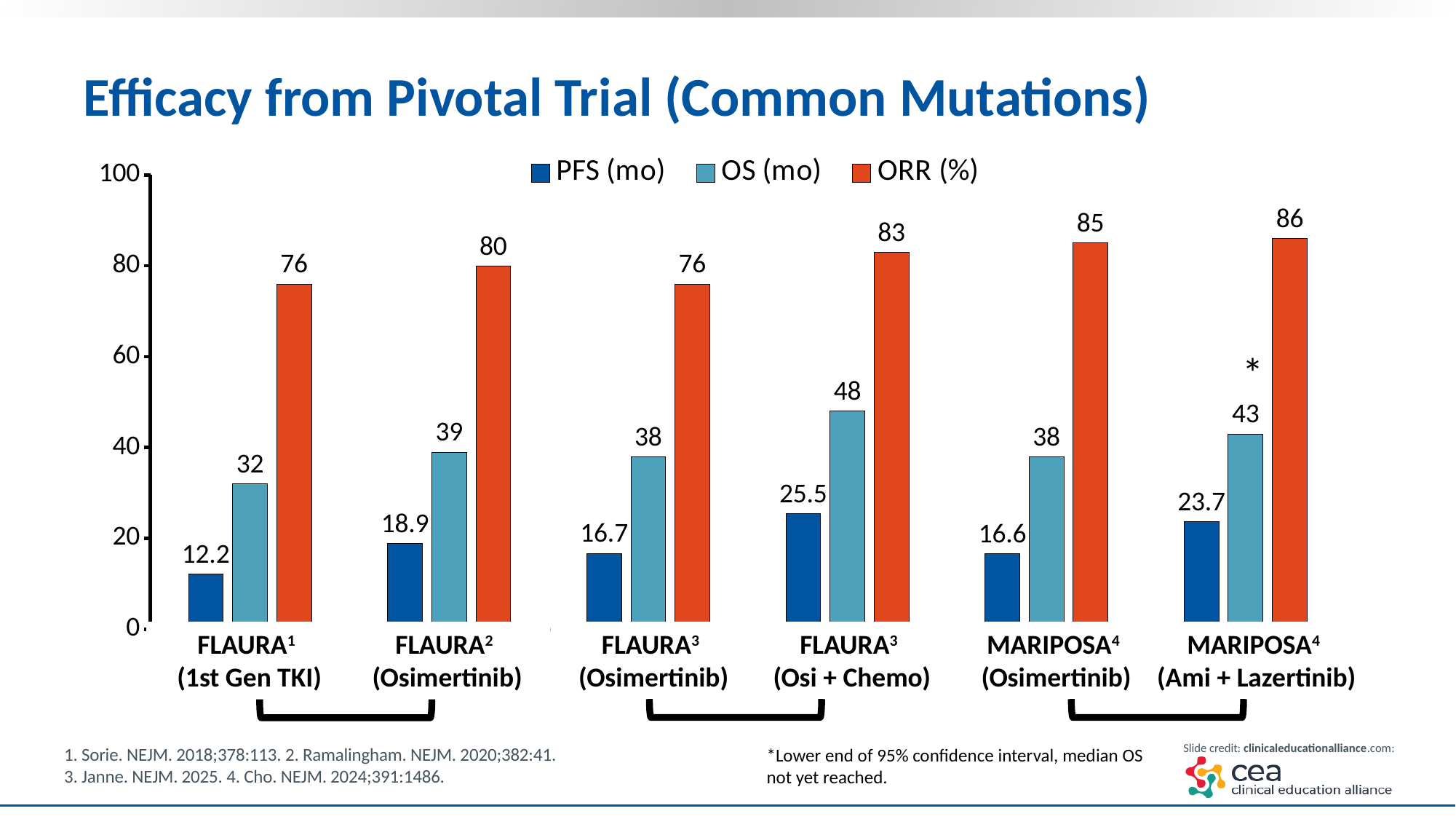
Which has the larger OS (mo): FLAURA² (Osimertinib) or MARIPOSA (Ami + Lazertinib)? MARIPOSA (Ami + Lazertinib) What is the ORR (%) value for MARIPOSA (Ami + Lazertinib)? 86 How many series does the legend list? 3 Which trial arm has the lowest PFS (mo)? FLAURA (1st Gen TKI) What is the PFS (mo) value for MARIPOSA (Osimertinib)? 16.6 How many trial arms (category groups) are shown on the x axis? 6 What kind of chart is shown on the slide? Bar chart Which trial arm has the highest ORR (%)? MARIPOSA (Ami + Lazertinib) What is the difference in PFS (mo) between FLAURA (Osi + Chemo) and the FLAURA³ (Osimertinib) arm next to it? 8.8 What is the PFS (mo) value for FLAURA (1st Gen TKI)? 12.2 What is the OS (mo) value for FLAURA (Osi + Chemo)? 48 What is the difference in ORR (%) between MARIPOSA (Ami + Lazertinib) and MARIPOSA (Osimertinib)? 1